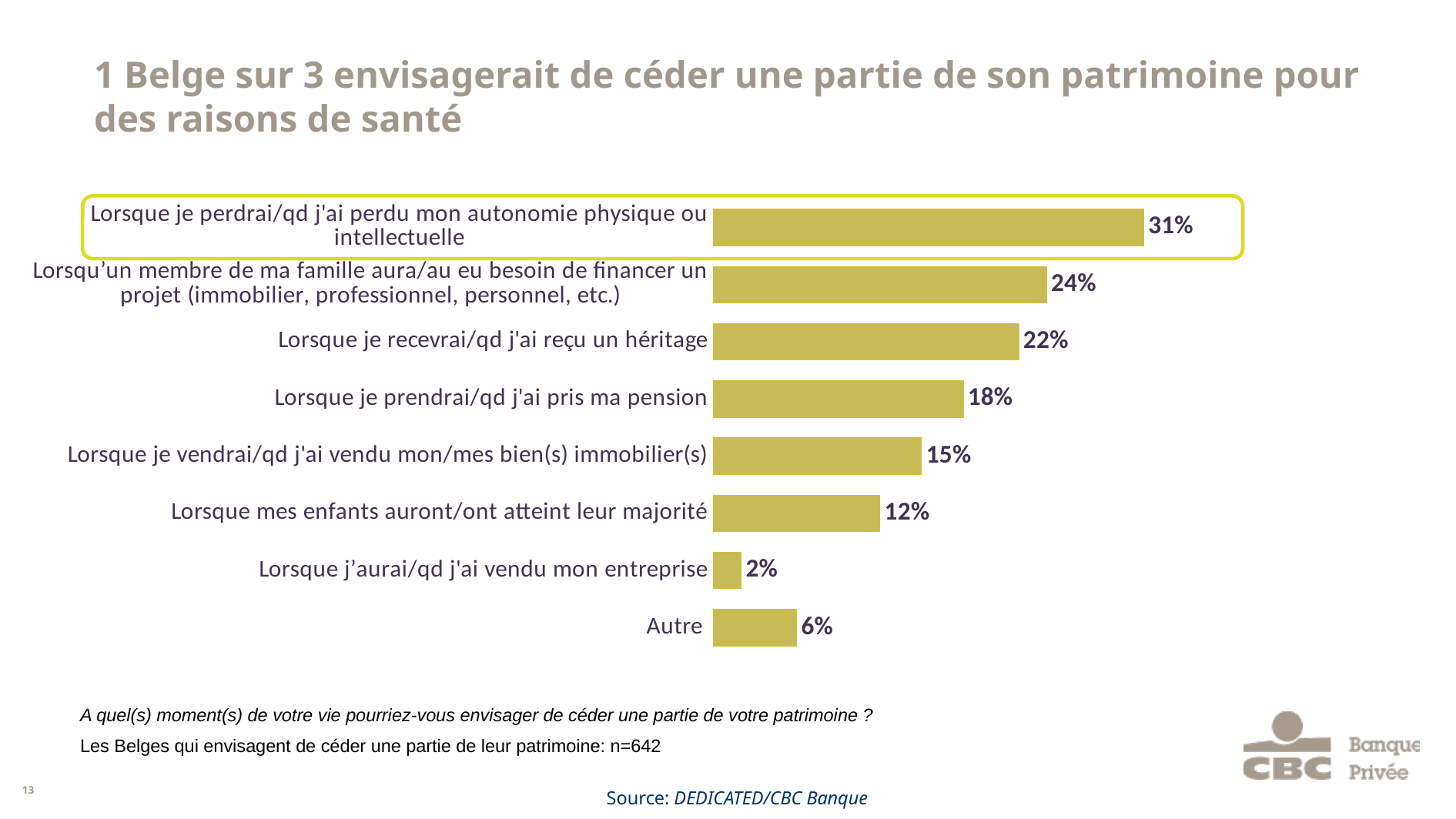
What is the value for "Lorsque je recevrai/qd j'ai reçu un héritage"? 22% What is the difference between the value for "Lorsque je perdrai/qd j'ai perdu mon autonomie physique ou intellectuelle" and the value for "Lorsqu'un membre de ma famille aura/au eu besoin de financer un projet"? 7% Which category has the highest value? Lorsque je perdrai/qd j'ai perdu mon autonomie physique ou intellectuelle What kind of chart is shown on the slide? Bar chart Which category has the lowest value? Lorsque j'aurai/qd j'ai vendu mon entreprise What is the sample size (n) stated below the chart? n=642 What is the difference between the value for "Lorsque je vendrai/qd j'ai vendu mon/mes bien(s) immobilier(s)" and the value for "Lorsque mes enfants auront/ont atteint leur majorité"? 3% What is the source cited at the bottom of the slide? DEDICATED/CBC Banque What is the value for "Lorsque je prendrai/qd j'ai pris ma pension"? 18% Which is larger: the value for "Autre" or the value for "Lorsque j'aurai/qd j'ai vendu mon entreprise"? Autre What is the value for "Autre"? 6% How many categories are shown in the chart? 8